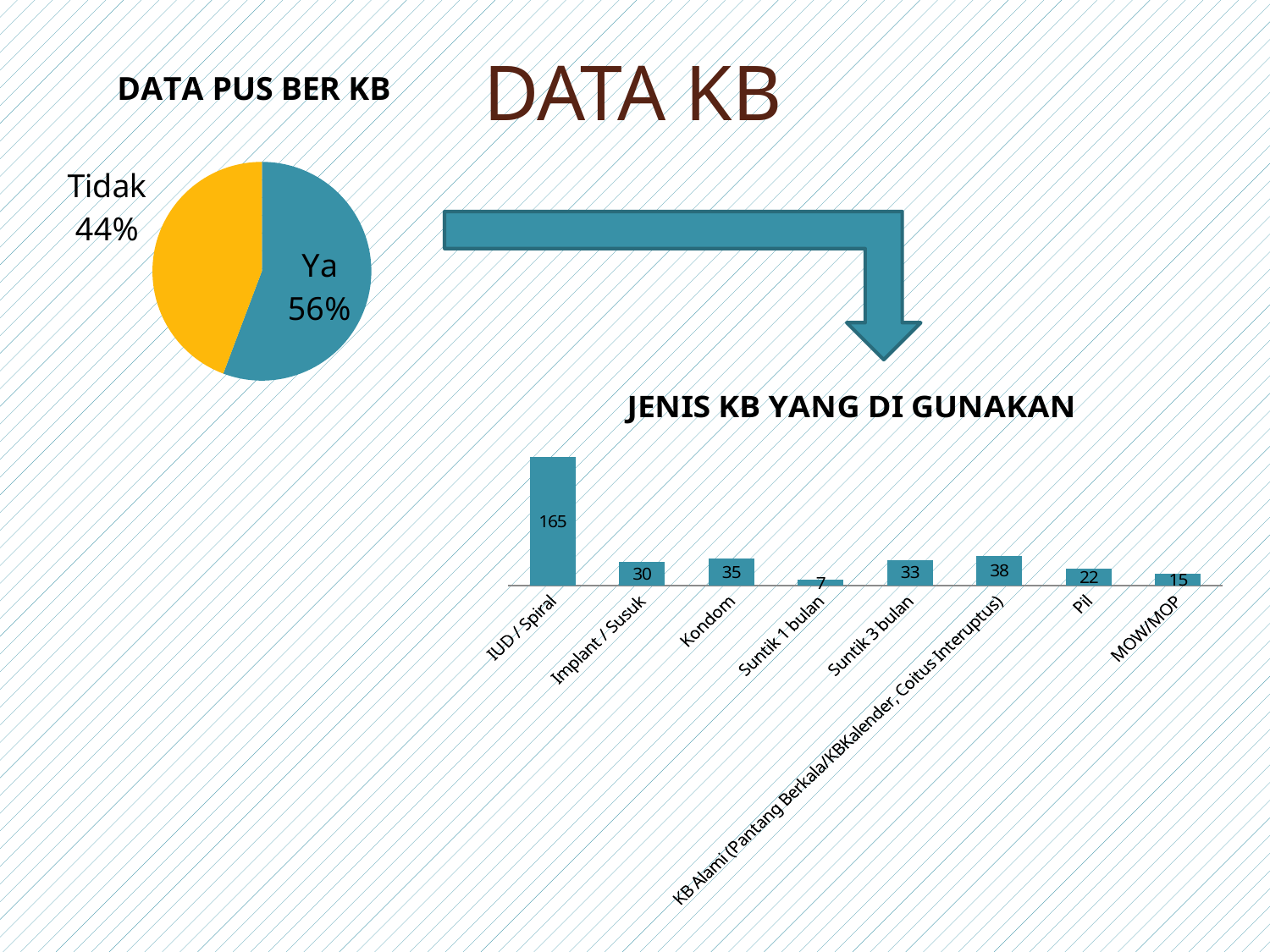
How many categories are shown in the 'JENIS KB YANG DI GUNAKAN' chart? 8 In the 'JENIS KB YANG DI GUNAKAN' chart, what is the difference between 'IUD / Spiral' and 'Pil'? 143 In the 'JENIS KB YANG DI GUNAKAN' chart, which category has the highest value? IUD / Spiral In the 'DATA PUS BER KB' pie chart, what share is labelled 'Tidak'? 44% In the 'DATA PUS BER KB' pie chart, what share is labelled 'Ya'? 56% What kind of chart is 'DATA PUS BER KB'? pie chart In the 'JENIS KB YANG DI GUNAKAN' chart, which category has the lowest value? Suntik 1 bulan In the 'JENIS KB YANG DI GUNAKAN' chart, which is larger, 'Suntik 3 bulan' or 'Implant / Susuk'? Suntik 3 bulan In the 'JENIS KB YANG DI GUNAKAN' chart, what is the value for 'IUD / Spiral'? 165 What kind of chart is 'JENIS KB YANG DI GUNAKAN'? bar chart In the 'DATA PUS BER KB' pie chart, which slice is larger, 'Ya' or 'Tidak'? Ya In the 'JENIS KB YANG DI GUNAKAN' chart, what is the value for 'Kondom'? 35